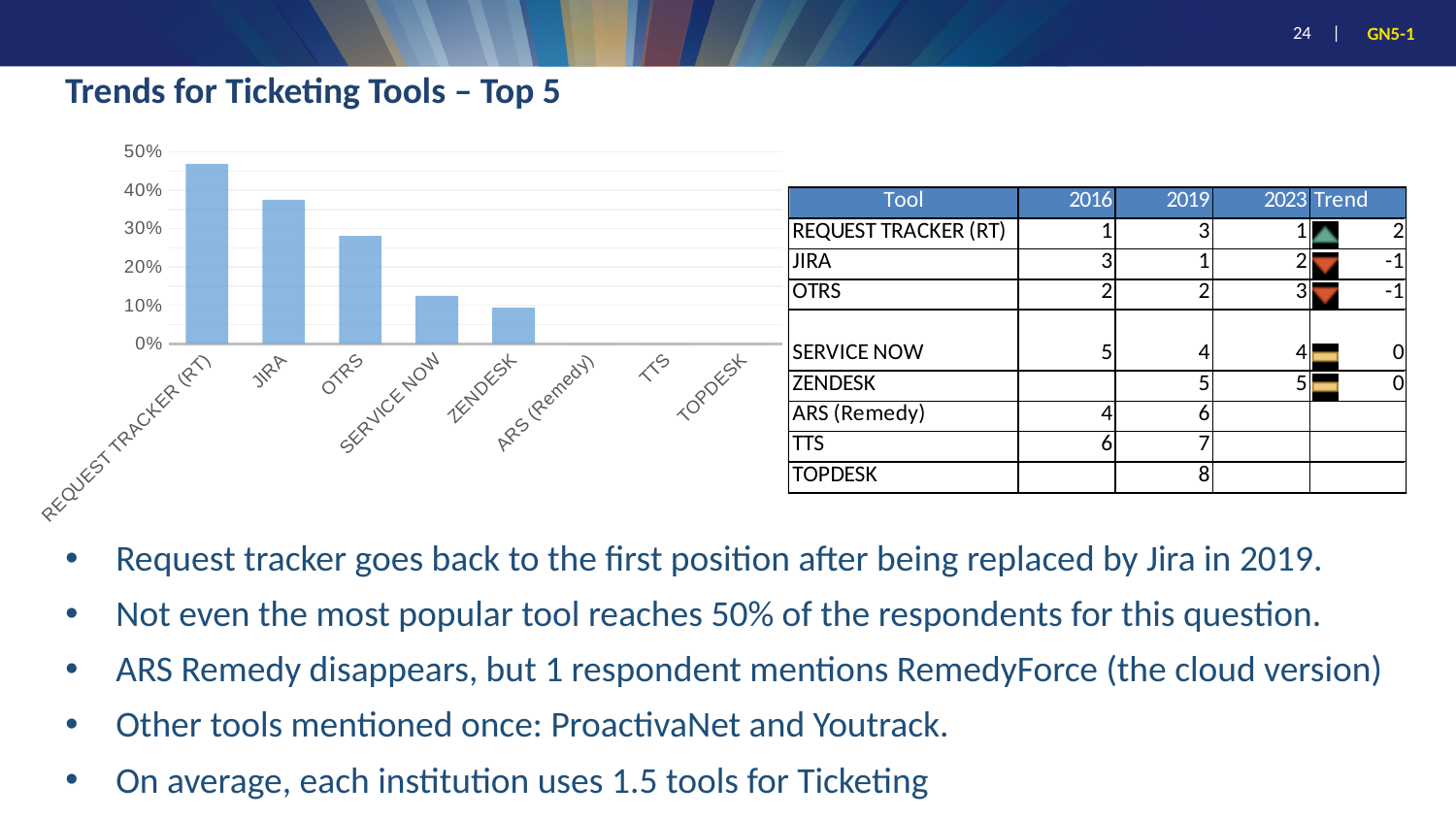
Is the value for REQUEST TRACKER (RT) greater or less than 40%? greater Is the value for OTRS greater or less than 20%? greater Which has a larger value in the chart, REQUEST TRACKER (RT) or JIRA? REQUEST TRACKER (RT) What is the title of the slide containing the chart? Trends for Ticketing Tools – Top 5 Is the value for JIRA greater or less than 30%? greater How many tool categories are listed along the x axis of the bar chart? 8 Which has a larger value in the chart, OTRS or SERVICE NOW? OTRS Which tool has the tallest bar in the chart? REQUEST TRACKER (RT) What kind of chart is shown on the slide? bar chart Do the bar values rise or fall moving from left to right along the x axis? fall